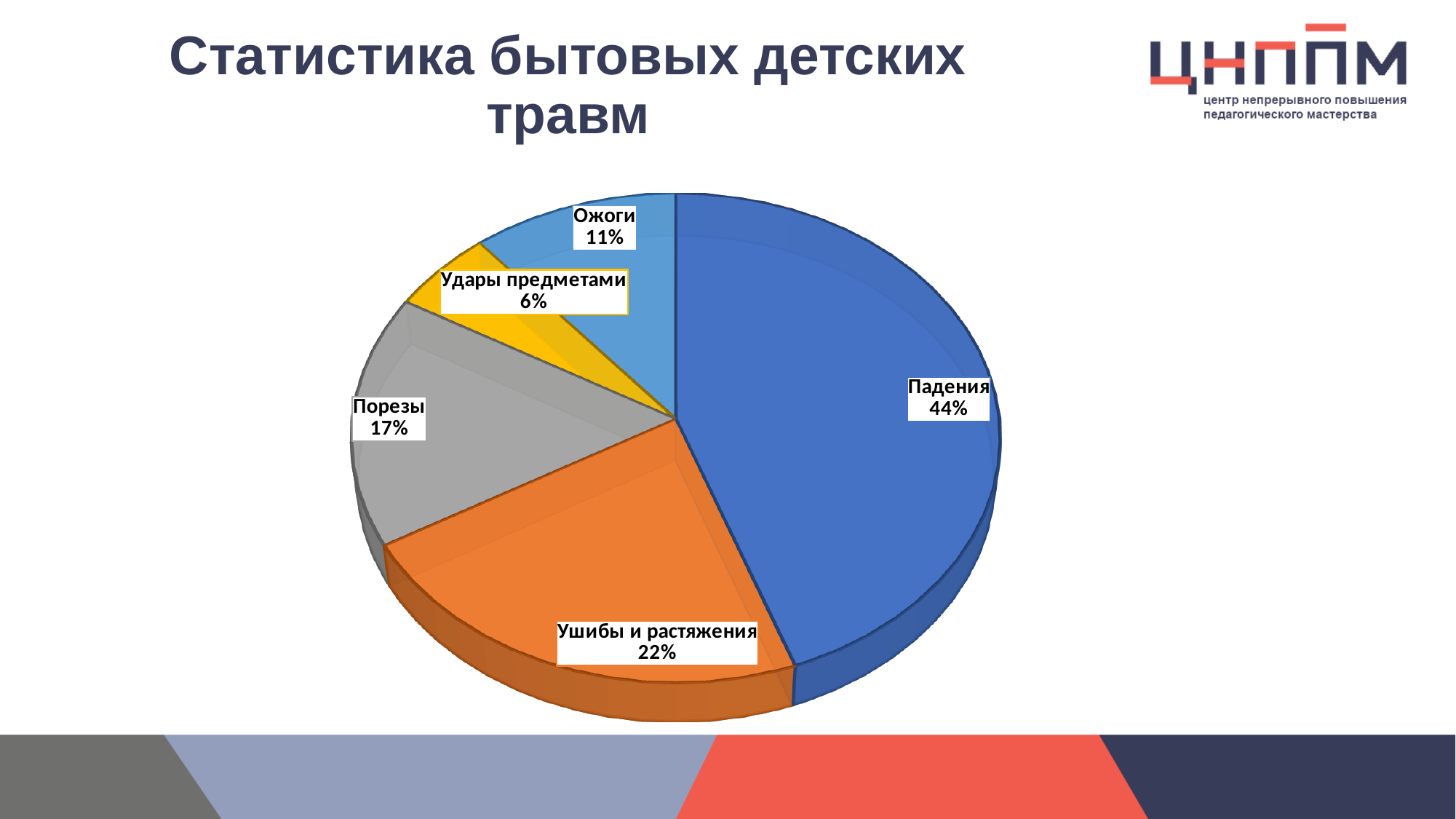
How many categories are shown in the pie chart? 5 Which category has the largest slice of the pie? Падения What is the title of the slide? Статистика бытовых детских травм What is the value shown for Ушибы и растяжения? 22% What is the difference in percentage points between Падения and Ушибы и растяжения? 22 Which is larger, Порезы or Ожоги? Порезы What share of the pie does Падения account for? 44% What is the value shown for Удары предметами? 6% Which category has the smallest slice of the pie? Удары предметами What is the value shown for Порезы? 17% What is the value shown for Ожоги? 11% What kind of chart is shown on the slide? Pie chart